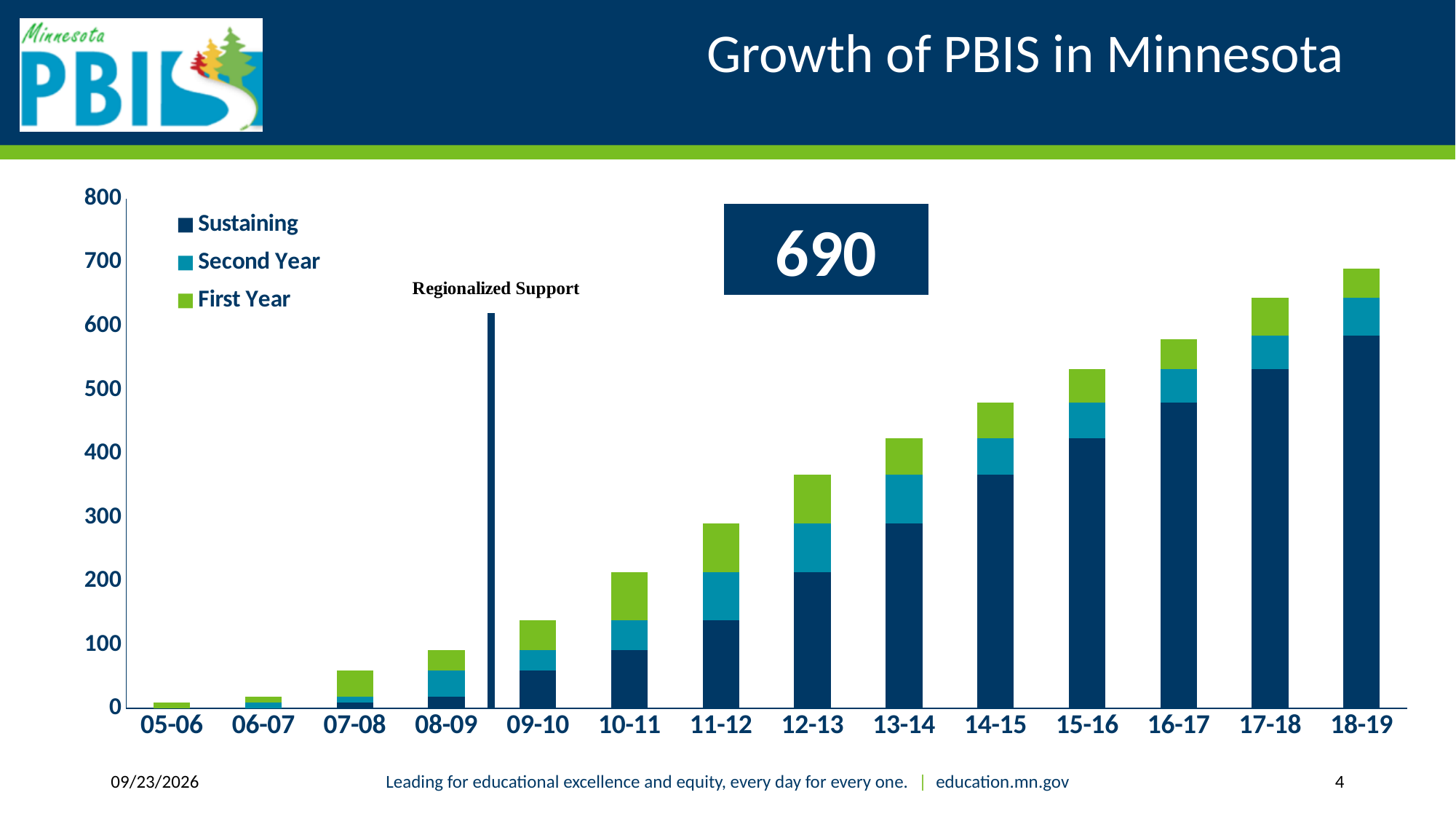
Which school year has the shortest stacked bar? 05-06 Is the total for 09-10 greater or less than 200? less How many series does the legend list? 3 Which has the larger total, 15-16 or 12-13? 15-16 Is the total for 14-15 greater or less than 500? less What number is displayed in the callout box above the chart? 690 What are the three series named in the legend? Sustaining, Second Year, First Year How many school-year categories are shown on the x axis? 14 Do the stacked bar totals rise or fall from 05-06 to 18-19? Rise Is the total for 18-19 greater or less than 600? greater What kind of chart is shown on the slide? Stacked bar chart Which school year has the tallest stacked bar? 18-19